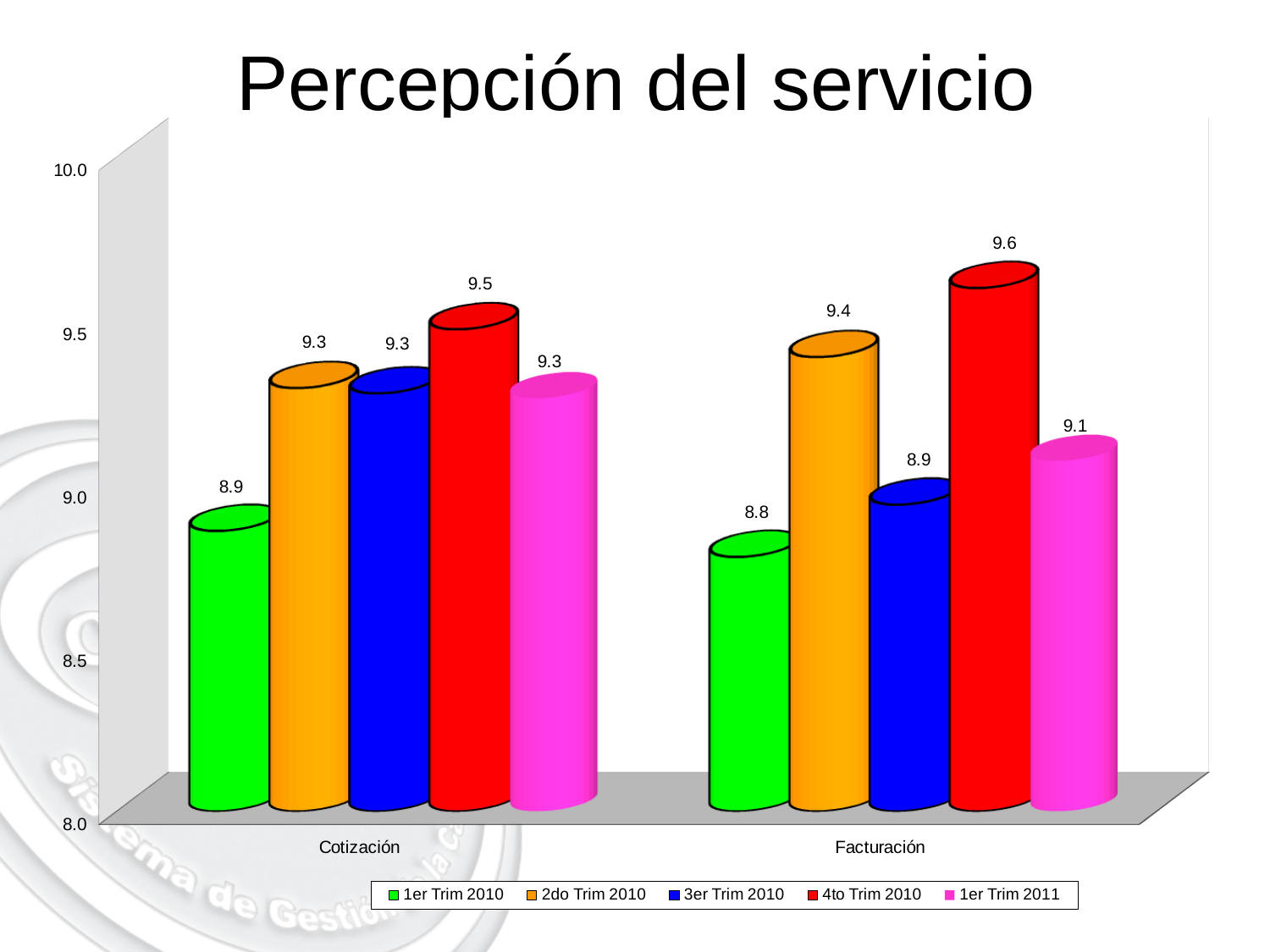
What is the value for 1er Trim 2011 in the Facturación category? 9.1 What is the title of the chart? Percepción del servicio How many series does the legend list? 5 How many categories are shown on the x axis? 2 What is the value for 1er Trim 2010 in the Cotización category? 8.9 What kind of chart is shown on the slide? Bar chart Which series has the highest value in the Facturación category? 4to Trim 2010 What is the difference between the 4to Trim 2010 value and the 1er Trim 2010 value in the Facturación category? 0.8 What is the value for 4to Trim 2010 in the Facturación category? 9.6 Which series has the lowest value in the Cotización category? 1er Trim 2010 Is the value for 3er Trim 2010 in Facturación greater or less than 9.0? less Which is larger: the 2do Trim 2010 value for Cotización or for Facturación? Facturación